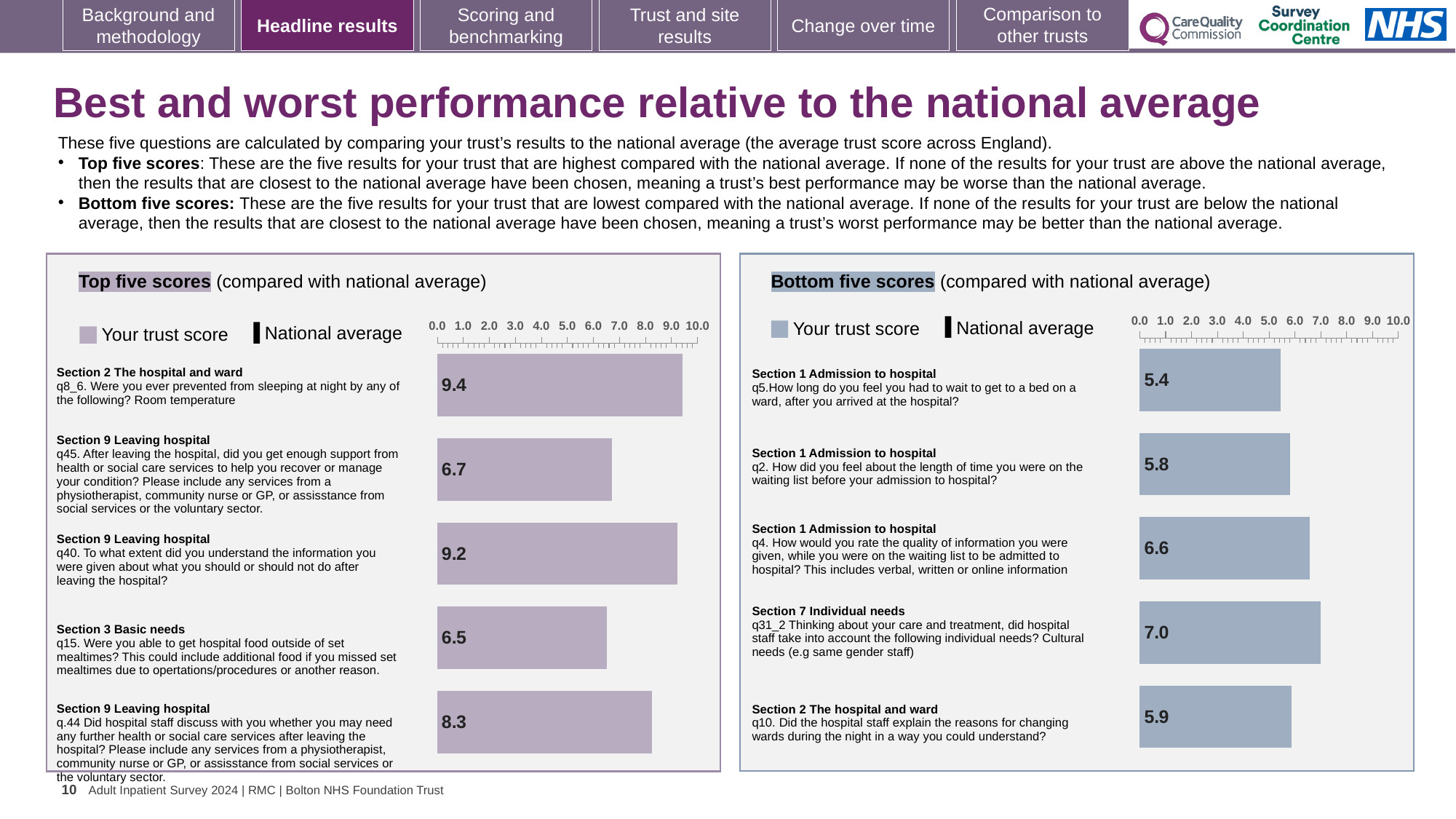
How many bars are plotted in the Bottom five scores chart? 5 In the Top five scores chart, what is the difference between the trust scores for q40 and q45? 2.5 In the Top five scores chart, what is the trust score for q15 (able to get hospital food outside of set mealtimes)? 6.5 What type of chart is used for the Top five scores? Bar chart In the Top five scores chart, what is the trust score for q8_6 (prevented from sleeping at night by room temperature)? 9.4 In the Bottom five scores chart, what is the trust score for q5 (how long you had to wait to get to a bed on a ward)? 5.4 In the Bottom five scores chart, what is the difference between the trust scores for q31_2 and q5? 1.6 In the Bottom five scores chart, what is the trust score for q31_2 (individual needs: cultural needs)? 7.0 In the Bottom five scores chart, which question has the lowest trust score? q5 (wait to get to a bed on a ward) In the Bottom five scores chart, which has the larger trust score: q2 or q10? q10 In the Top five scores chart, is the trust score for q.44 greater or less than 8.0? greater In the Top five scores chart, which question has the highest trust score? q8_6 (Room temperature)